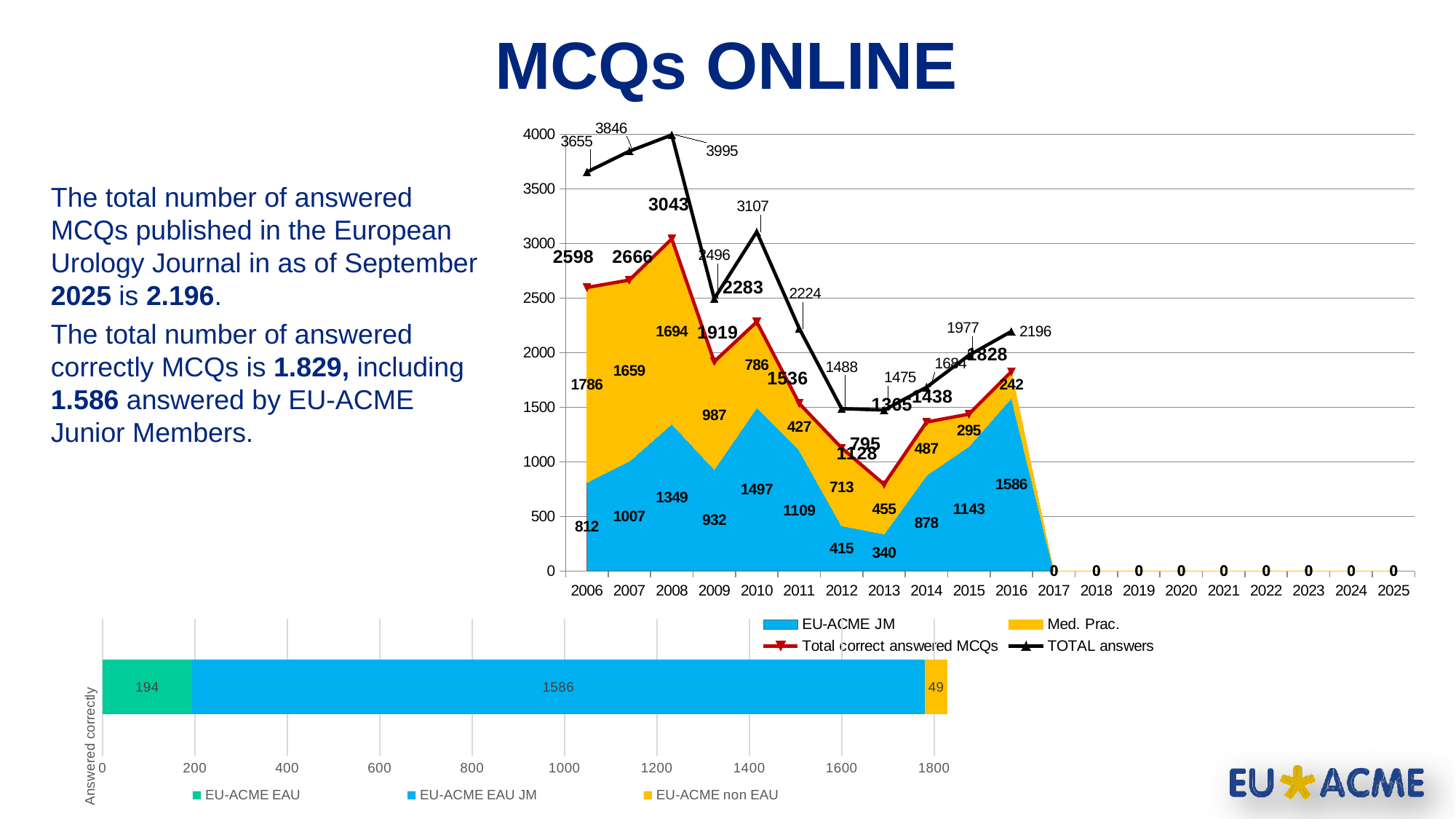
How many series does the legend of the top chart list? 4 In the top chart, what is the TOTAL answers value for 2008? 3995 In the bottom chart, what is the value for EU-ACME EAU? 194 In the top chart, what is the difference between the TOTAL answers values for 2016 and 2015? 219 In the top chart, what is the Med. Prac. value for 2006? 1786 In the bottom chart, what is the total of the stacked bar? 1829 In the top chart, which is larger: the Med. Prac. value for 2012 or for 2013? 2012 What kind of chart is the bottom chart? Bar chart In the top chart, what is the EU-ACME JM value for 2016? 1586 In the top chart, which year has the highest TOTAL answers value? 2008 In the top chart, which year has the lowest EU-ACME JM value among the years with non-zero data? 2013 In the bottom chart, which segment is the smallest? EU-ACME non EAU